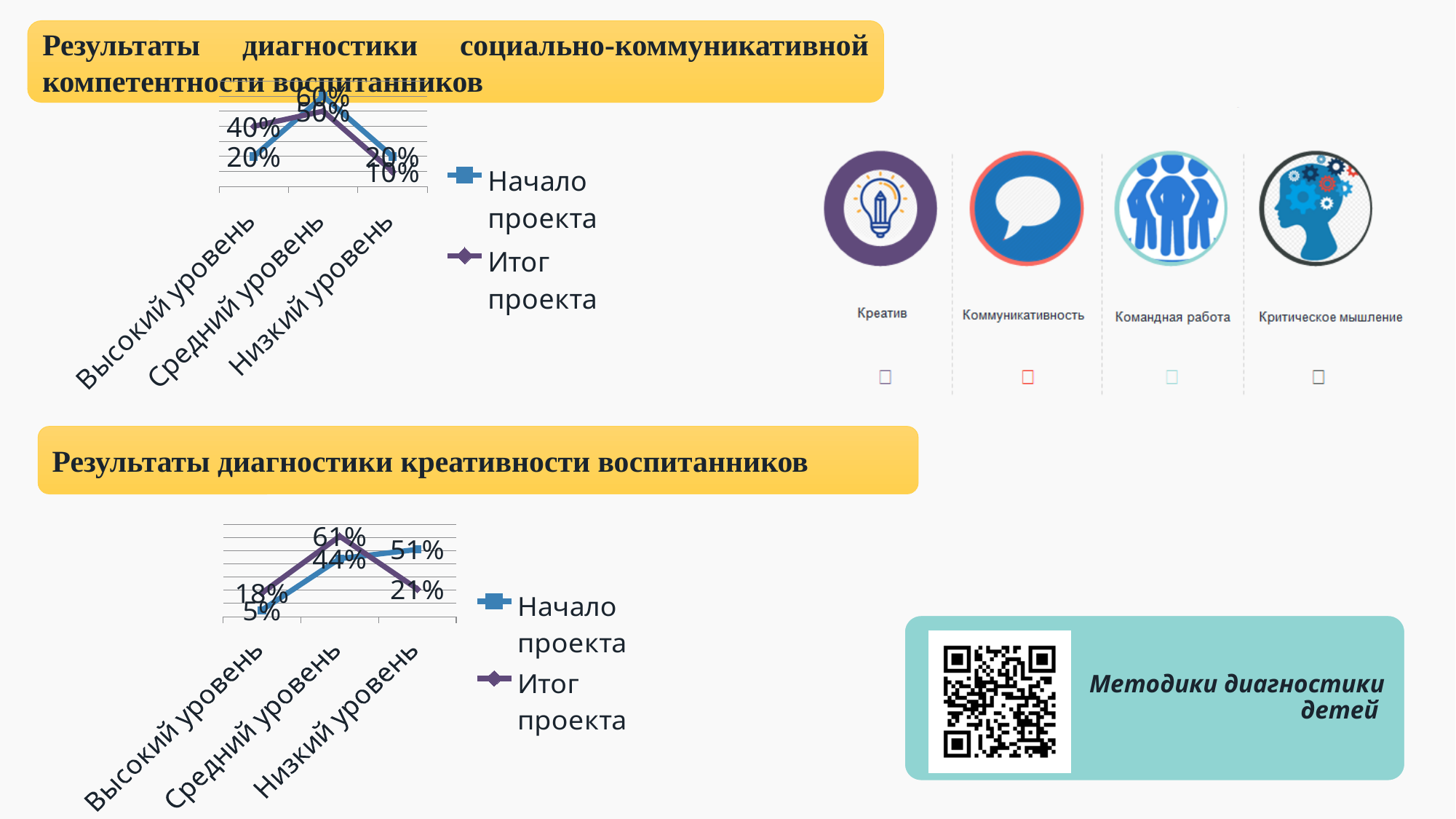
What kind of chart is shown under the title 'Результаты диагностики креативности воспитанников'? line chart What are the two legend entries of the chart 'Результаты диагностики креативности воспитанников'? Начало проекта, Итог проекта In the chart 'Результаты диагностики креативности воспитанников', how many series does the legend list? 2 In the top chart 'Результаты диагностики социально-коммуникативной компетентности воспитанников', what is the value of 'Итог проекта' for 'Высокий уровень'? 40% In the chart 'Результаты диагностики креативности воспитанников', what is the difference between 'Итог проекта' and 'Начало проекта' for 'Средний уровень'? 17% In the chart 'Результаты диагностики креативности воспитанников', how many categories are on the x axis? 3 In the chart 'Результаты диагностики креативности воспитанников', which series has the larger value for 'Низкий уровень'? Начало проекта In the chart 'Результаты диагностики креативности воспитанников', what is the value of 'Начало проекта' for 'Высокий уровень'? 5% In the chart 'Результаты диагностики креативности воспитанников', what is the value of 'Начало проекта' for 'Низкий уровень'? 51% In the chart 'Результаты диагностики креативности воспитанников', which category has the highest value for 'Итог проекта'? Средний уровень In the chart 'Результаты диагностики креативности воспитанников', what is the value of 'Итог проекта' for 'Средний уровень'? 61% In the chart 'Результаты диагностики креативности воспитанников', which category has the lowest value for 'Начало проекта'? Высокий уровень